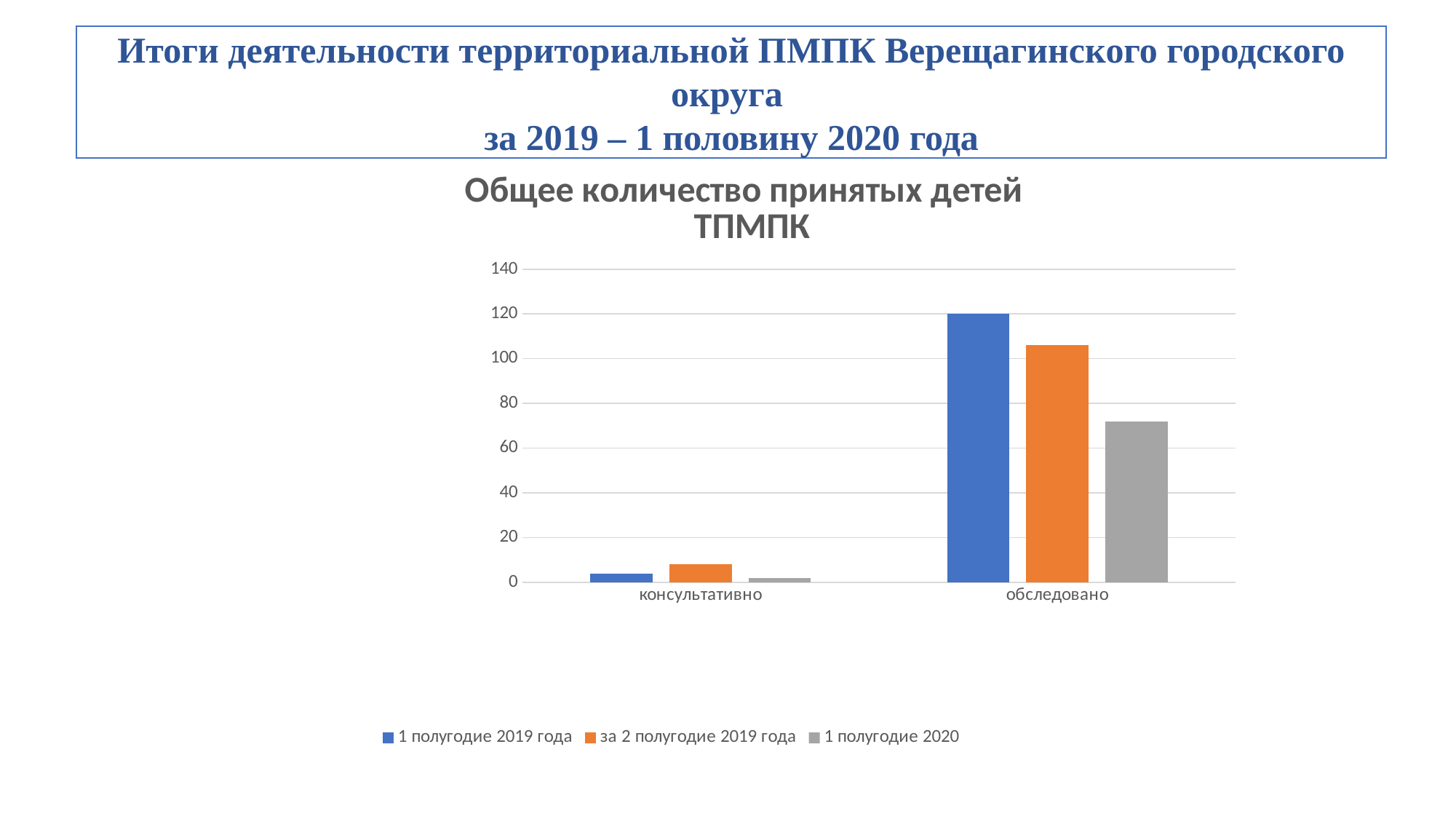
Which is larger: the value for '1 полугодие 2020' in 'обследовано' or in 'консультативно'? обследовано Is the value for 'за 2 полугодие 2019 года' in the 'обследовано' category greater or less than 100? greater Is the value for '1 полугодие 2020' in the 'обследовано' category greater or less than 80? less What is the title of the chart? Общее количество принятых детей ТПМПК Which category has the higher values overall, 'консультативно' or 'обследовано'? обследовано What kind of chart is shown on the slide? bar chart Which series has the highest value in the 'обследовано' category? 1 полугодие 2019 года Which series has the highest value in the 'консультативно' category? за 2 полугодие 2019 года How many series does the legend list? 3 What is the value for '1 полугодие 2019 года' in the 'обследовано' category? 120 Which series has the lowest value in the 'обследовано' category? 1 полугодие 2020 How many categories are shown on the x axis? 2